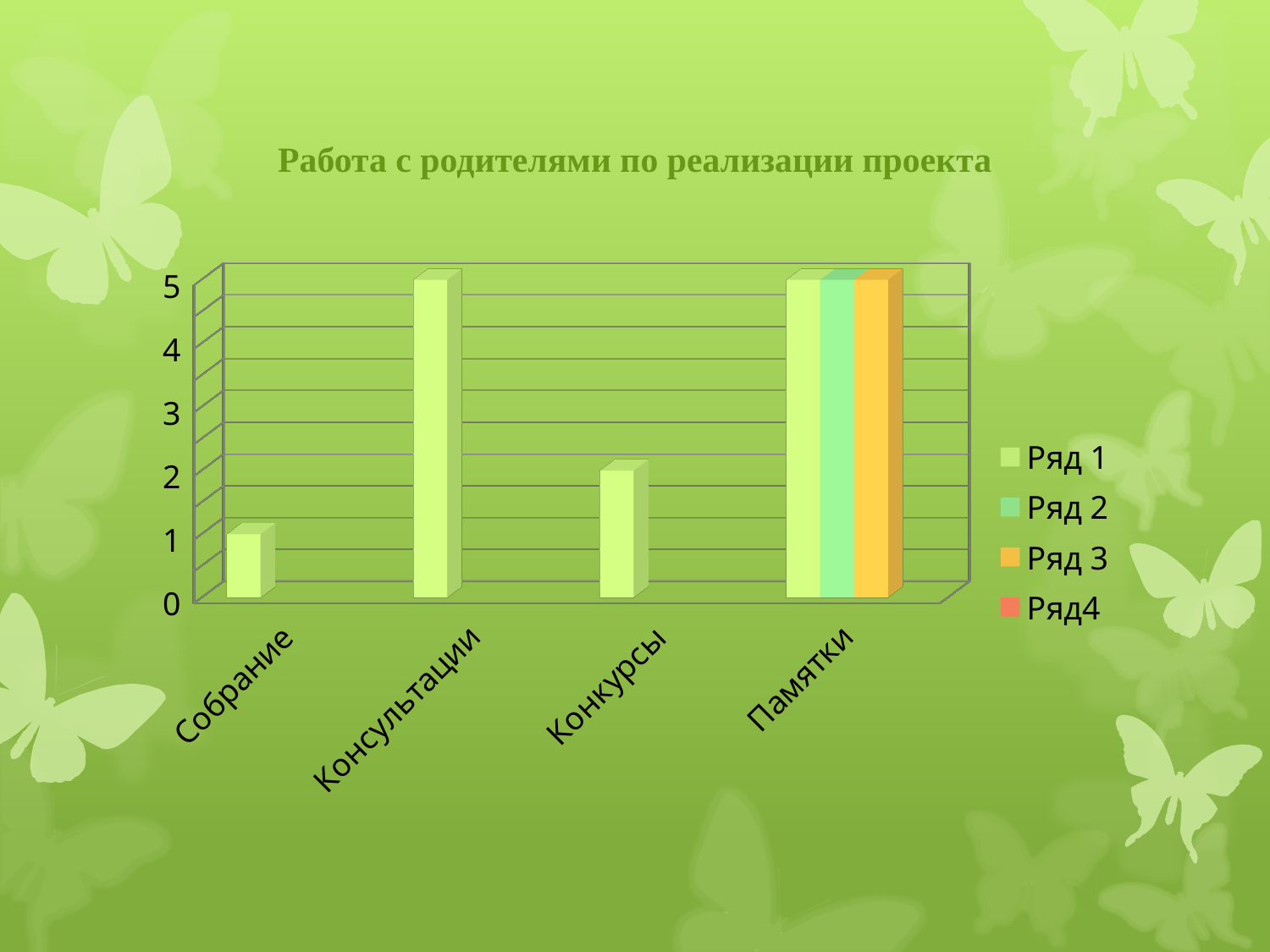
Which category has the lowest value for Ряд 1? Собрание What is the value of Ряд 1 for Конкурсы? 2 How many series does the legend list? 4 What kind of chart is shown on the slide? bar chart What is the value of Ряд 1 for Консультации? 5 Which is larger for Ряд 1: Конкурсы or Собрание? Конкурсы What is the difference between the Ряд 1 values for Консультации and Конкурсы? 3 What is the value of Ряд 2 for Памятки? 5 What is the value of Ряд 1 for Собрание? 1 How many categories are shown on the x axis? 4 What is the title of the chart? Работа с родителями по реализации проекта Which category has bars for Ряд 1, Ряд 2 and Ряд 3? Памятки